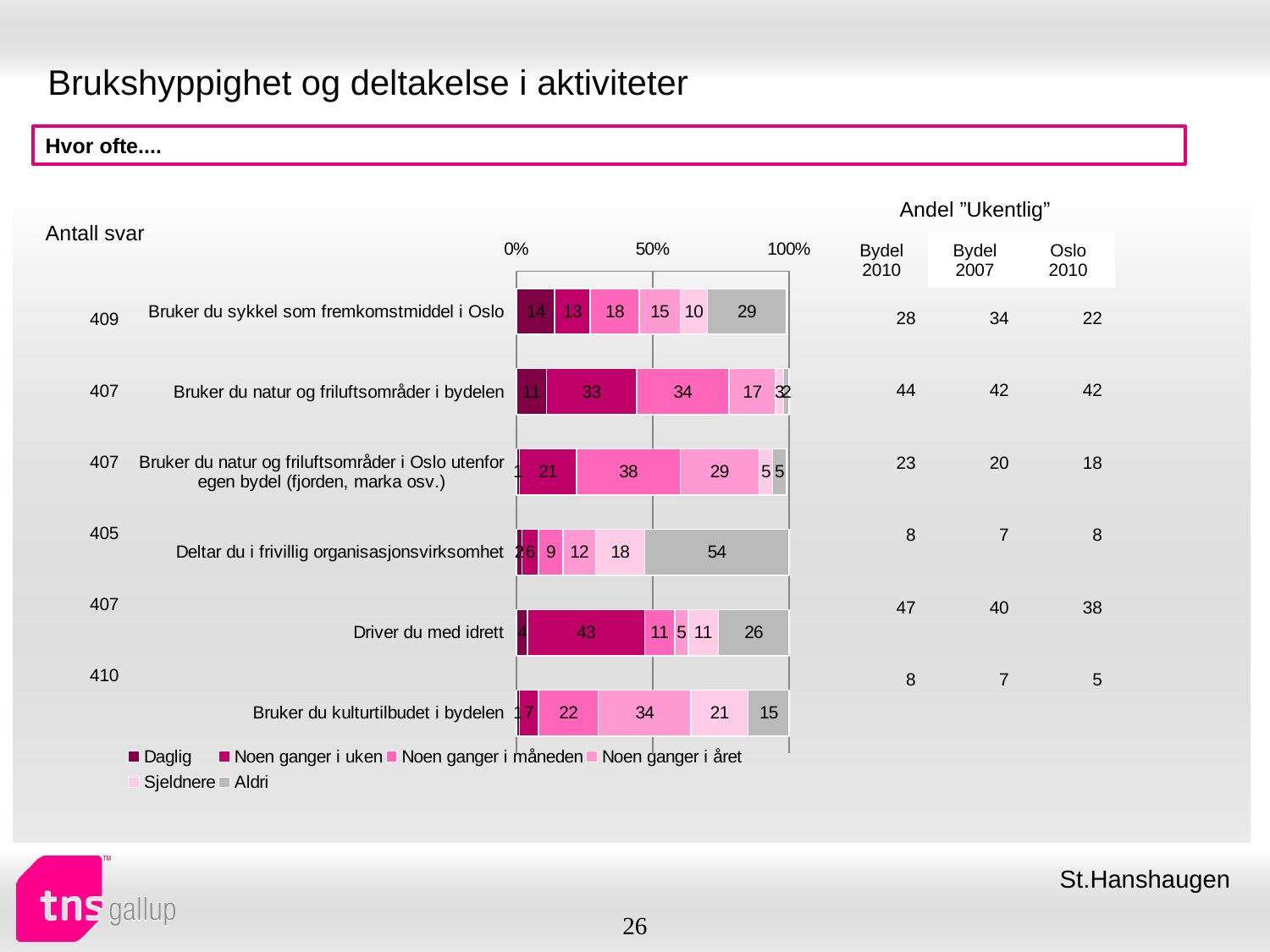
What kind of chart is shown on the slide? Stacked bar chart Which activity has the highest "Aldri" value? Deltar du i frivillig organisasjonsvirksomhet What is the value for "Aldri" in the bar for "Bruker du sykkel som fremkomstmiddel i Oslo"? 29 What is the value for "Aldri" in the bar for "Deltar du i frivillig organisasjonsvirksomhet"? 54 Which is larger: the "Aldri" value for "Bruker du sykkel som fremkomstmiddel i Oslo" or for "Driver du med idrett"? Bruker du sykkel som fremkomstmiddel i Oslo What is the value for "Daglig" in the bar for "Bruker du sykkel som fremkomstmiddel i Oslo"? 14 What is the value for "Noen ganger i uken" in the bar for "Driver du med idrett"? 43 What is the value for "Noen ganger i året" in the bar for "Bruker du kulturtilbudet i bydelen"? 34 What is the difference between the "Aldri" values for "Deltar du i frivillig organisasjonsvirksomhet" and "Bruker du kulturtilbudet i bydelen"? 39 What is the value for "Noen ganger i måneden" in the bar for "Bruker du natur og friluftsområder i Oslo utenfor egen bydel (fjorden, marka osv.)"? 38 How many series does the legend list? 6 How many activities (categories) are shown in the chart? 6